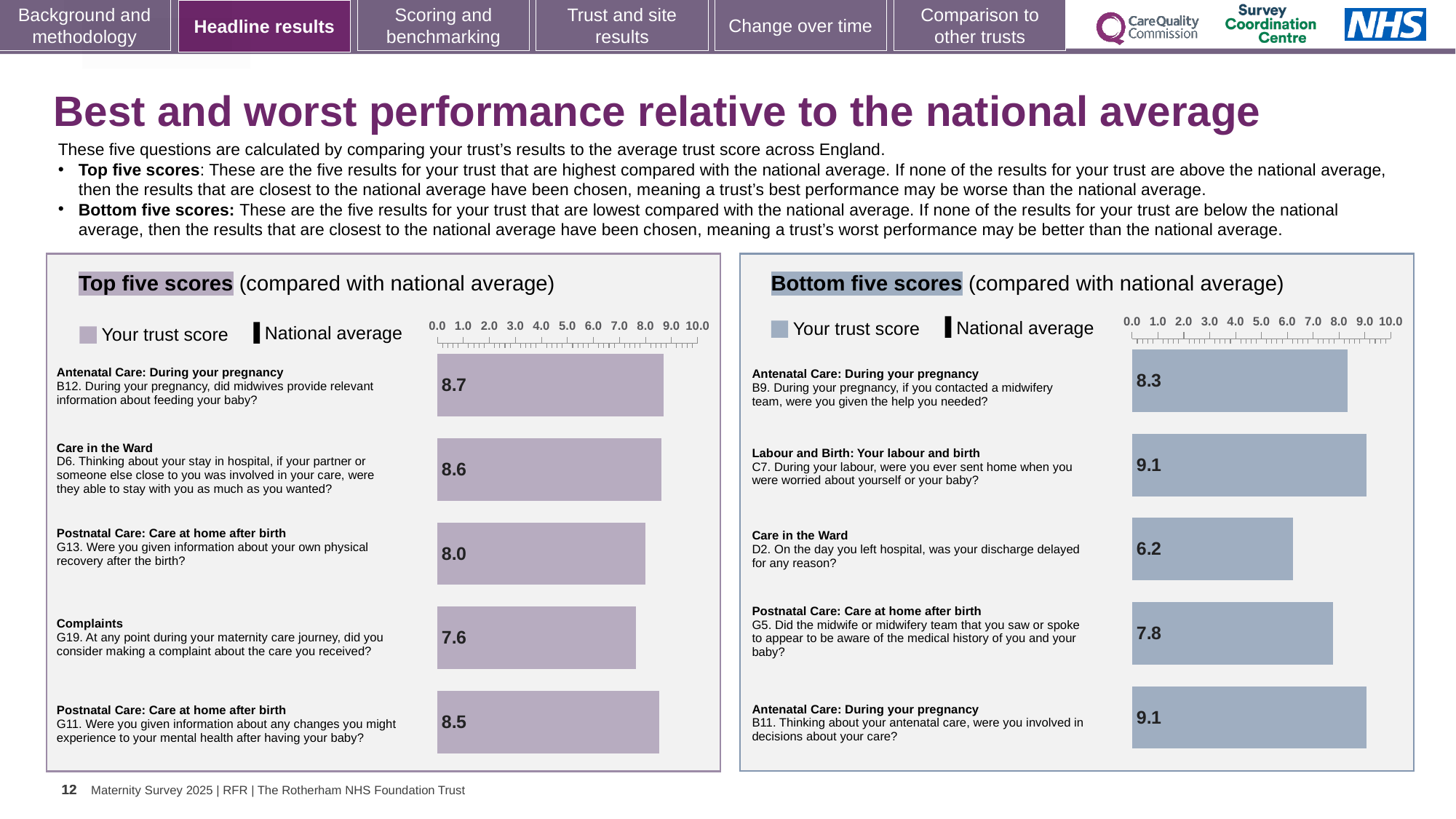
What kind of chart is the Top five scores chart? Bar chart In the Top five scores chart, which question has the lowest trust score? G19 (Complaints) How many questions are shown in the Bottom five scores chart? 5 In the Bottom five scores chart, which question has the lowest trust score? D2 (Care in the Ward) In the Bottom five scores chart, what is the difference between the trust scores for C7 and D2? 2.9 In the Bottom five scores chart, which has the larger trust score, B9 or G5? B9 In the Bottom five scores chart, what is the trust score for question D2 about discharge being delayed? 6.2 In the Top five scores chart, what is the trust score for question G19 about considering making a complaint? 7.6 In the Top five scores chart, what is the trust score for question B12 about midwives providing relevant information about feeding your baby? 8.7 In the Top five scores chart, what is the difference between the trust scores for B12 and G19? 1.1 In the Top five scores chart, which question has the highest trust score? B12 (Antenatal Care: During your pregnancy) In the Bottom five scores chart, what is the trust score for question G5 about the midwife being aware of your medical history? 7.8